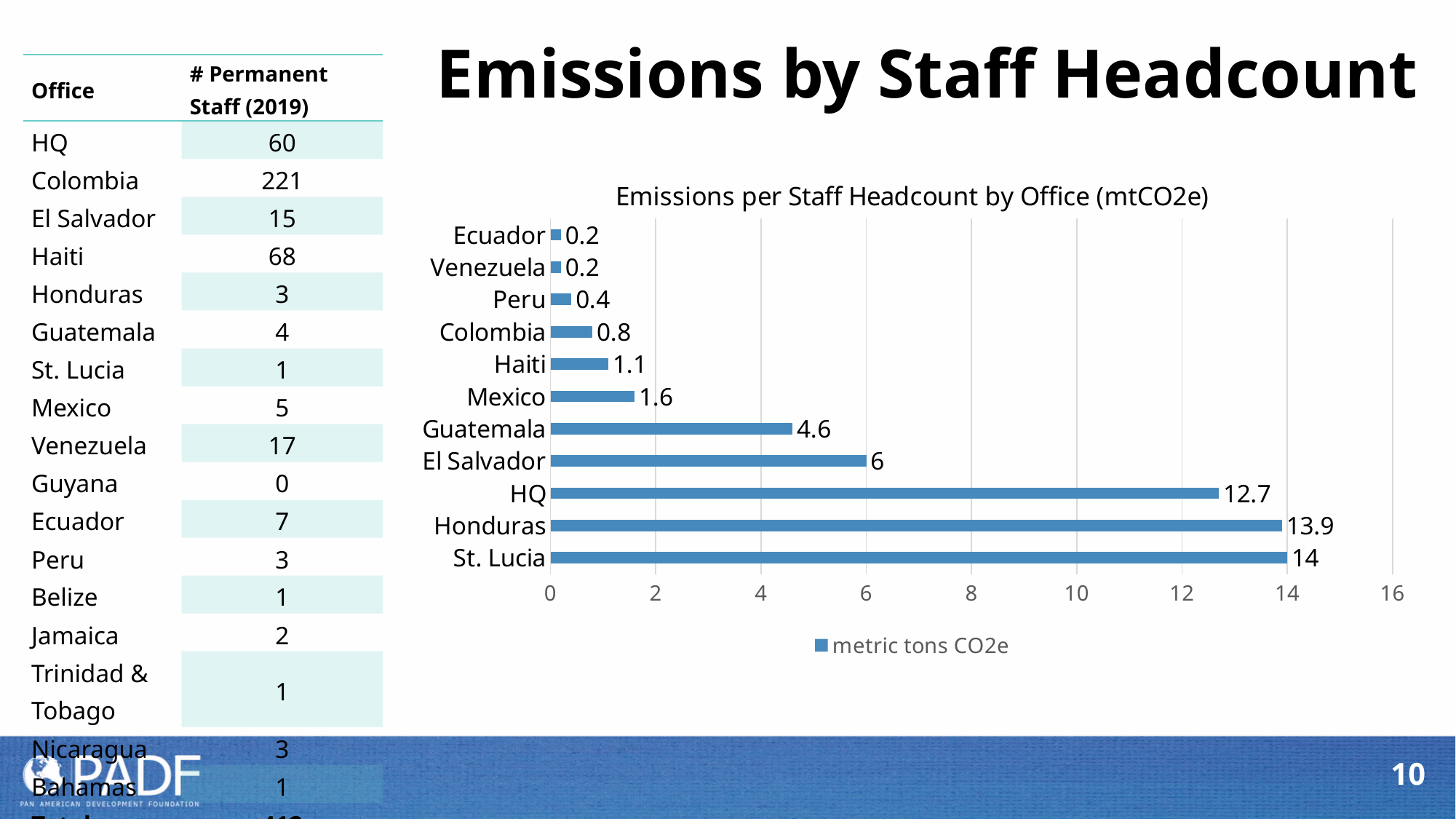
Which office has the highest emissions per staff headcount? St. Lucia Is the value for Honduras greater or less than 12? greater How many offices are shown in the chart? 11 What is the emissions per staff headcount value for Haiti? 1.1 What is the difference between the values for Honduras and HQ? 1.2 What is the title of the chart? Emissions per Staff Headcount by Office (mtCO2e) What is the legend entry of the chart? metric tons CO2e Which has a larger value, El Salvador or Guatemala? El Salvador What kind of chart is shown on the slide? bar chart How many series does the chart legend list? 1 What is the emissions per staff headcount value for Guatemala? 4.6 What is the emissions per staff headcount value for HQ? 12.7